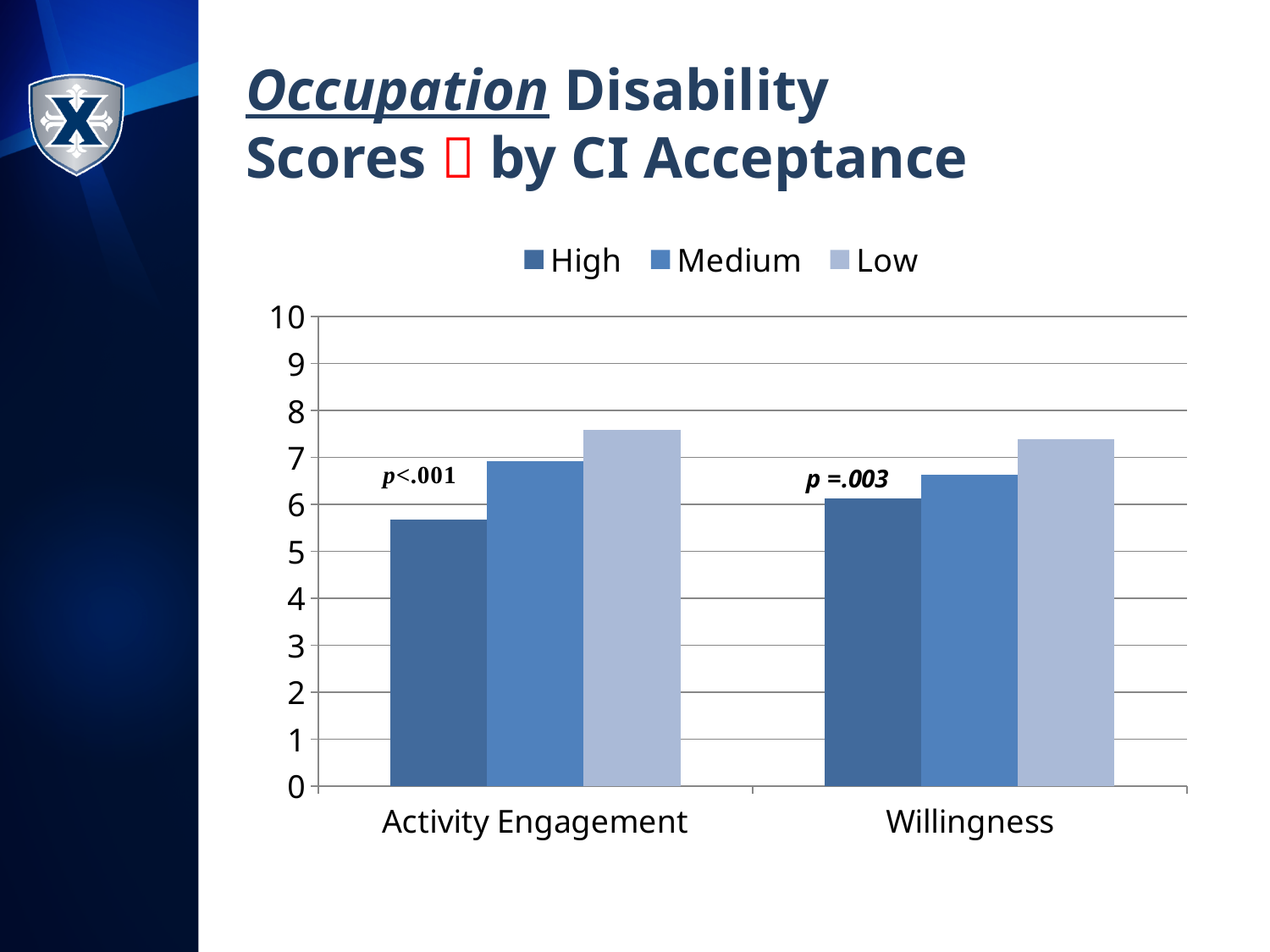
Is the value for Low in Activity Engagement greater or less than 7? greater Which is larger: the High value for Activity Engagement or the High value for Willingness? Willingness Is the value for High in Activity Engagement greater or less than 6? less Is the value for Low in Willingness greater or less than 7? greater Which series has the lowest value for Willingness? High How many series does the legend list? 3 Which series has the lowest value for Activity Engagement? High How many categories are shown on the x axis? 2 Which series has the highest value for Activity Engagement? Low Which series has the highest value for Willingness? Low What kind of chart is shown on the slide? bar chart What p-value is annotated above the Activity Engagement bars? p<.001